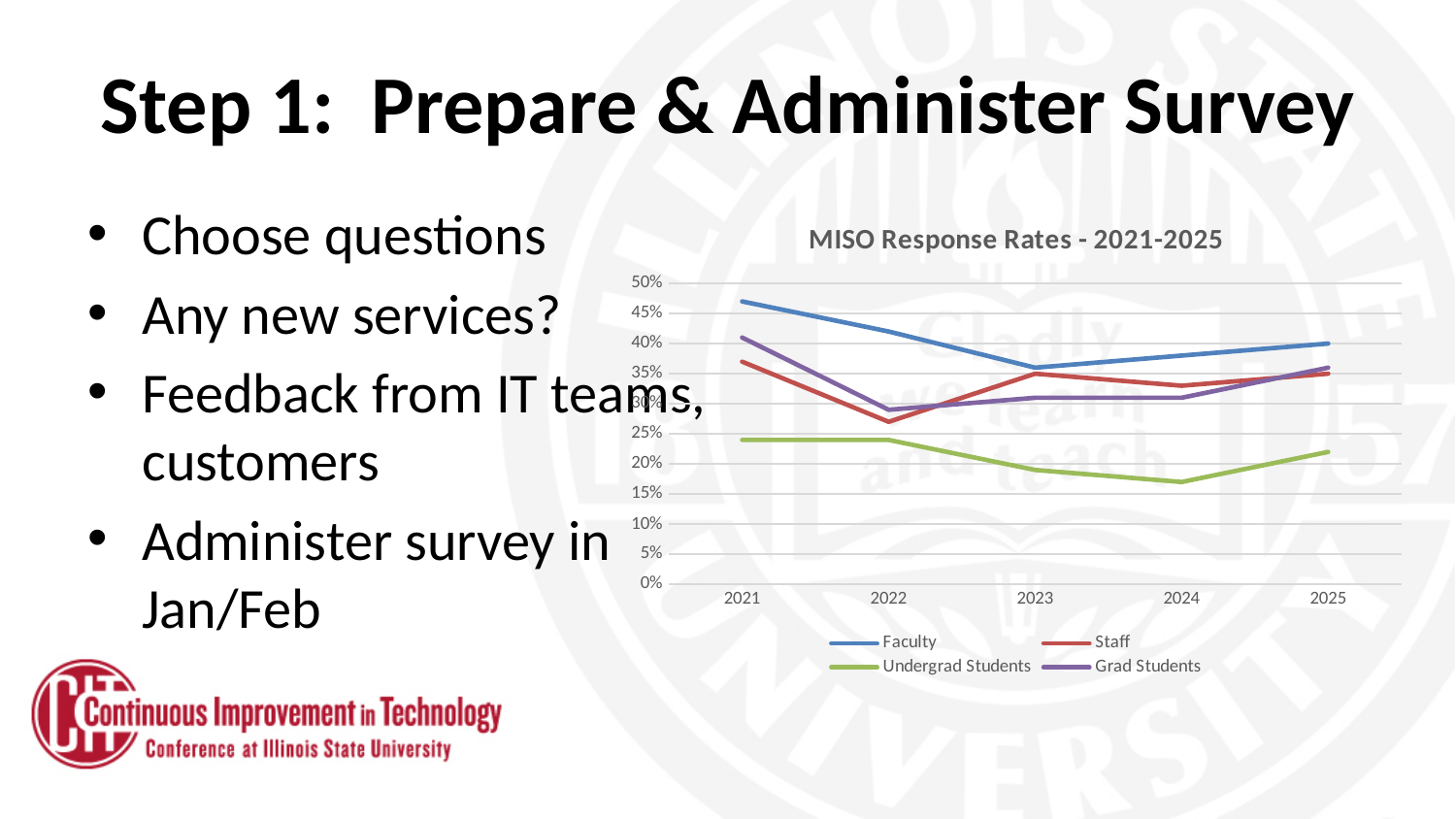
In 2023, which is larger: the Faculty response rate or the Undergrad Students response rate? Faculty Is the Staff response rate in 2022 greater or less than 30%? less How many series does the chart's legend list? 4 What is the title of the chart? MISO Response Rates - 2021-2025 Does the Faculty response rate rise or fall from 2021 to 2023? fall How many years are shown along the x axis of the chart? 5 Which group had the highest response rate in 2021? Faculty What kind of chart is shown on the slide? line chart Which colour is used for the Undergrad Students line? green Which group had the lowest response rate in 2024? Undergrad Students Is the Faculty response rate in 2021 greater or less than 45%? greater Is the Undergrad Students response rate in 2024 greater or less than 20%? less